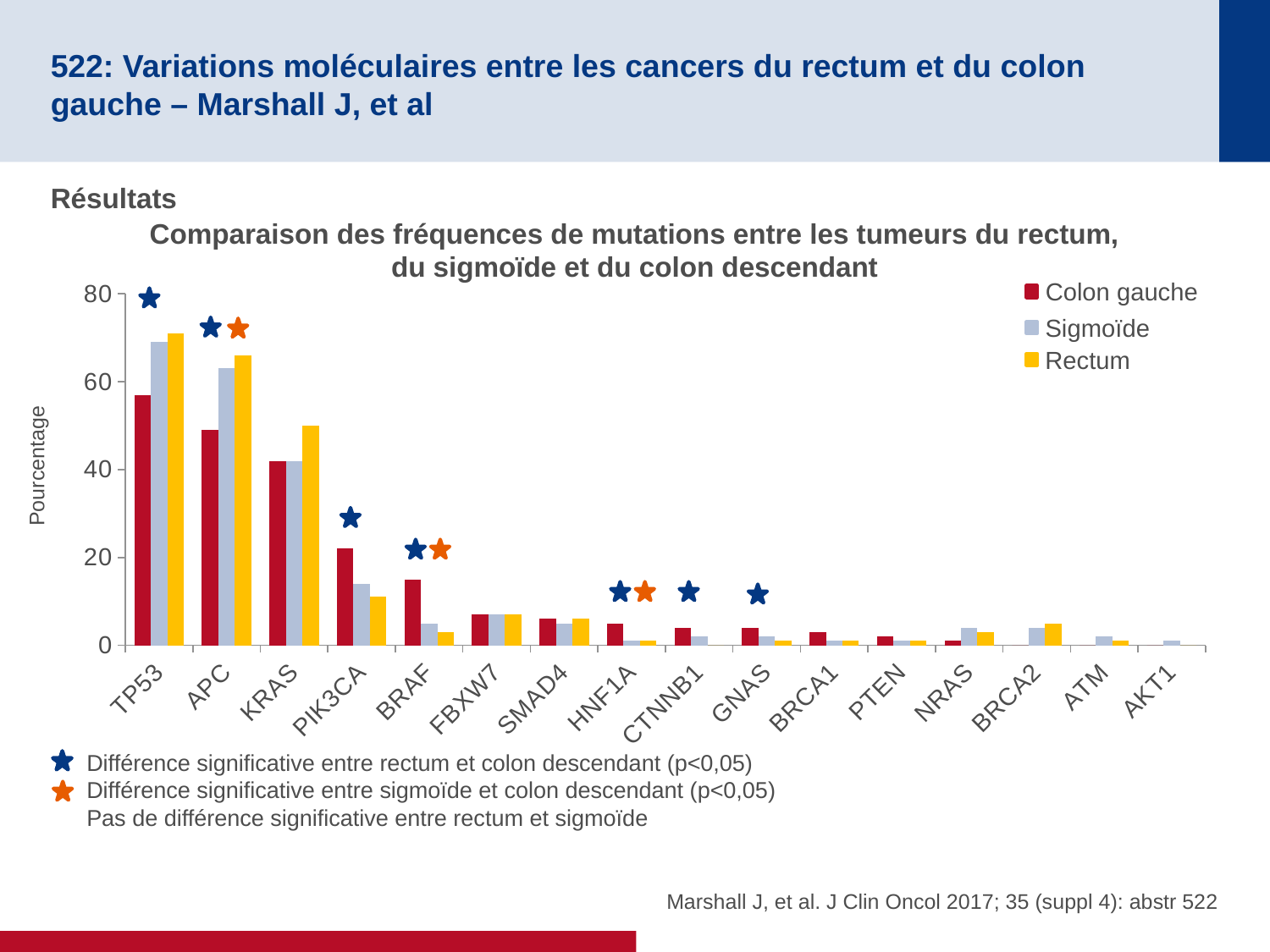
What is the label of the y axis? Pourcentage Is the Colon gauche value for APC greater or less than 60? less Is the Rectum value for TP53 greater or less than 60? greater For PIK3CA, which is larger: the Colon gauche value or the Rectum value? Colon gauche For KRAS, which is larger: the Rectum value or the Colon gauche value? Rectum Which gene has the highest Colon gauche value? TP53 How many series does the legend list? 3 Which gene has the highest Rectum value? TP53 Is the Colon gauche value for BRAF greater or less than 20? less What kind of chart is shown on the slide? Bar chart How many genes are shown along the x axis? 16